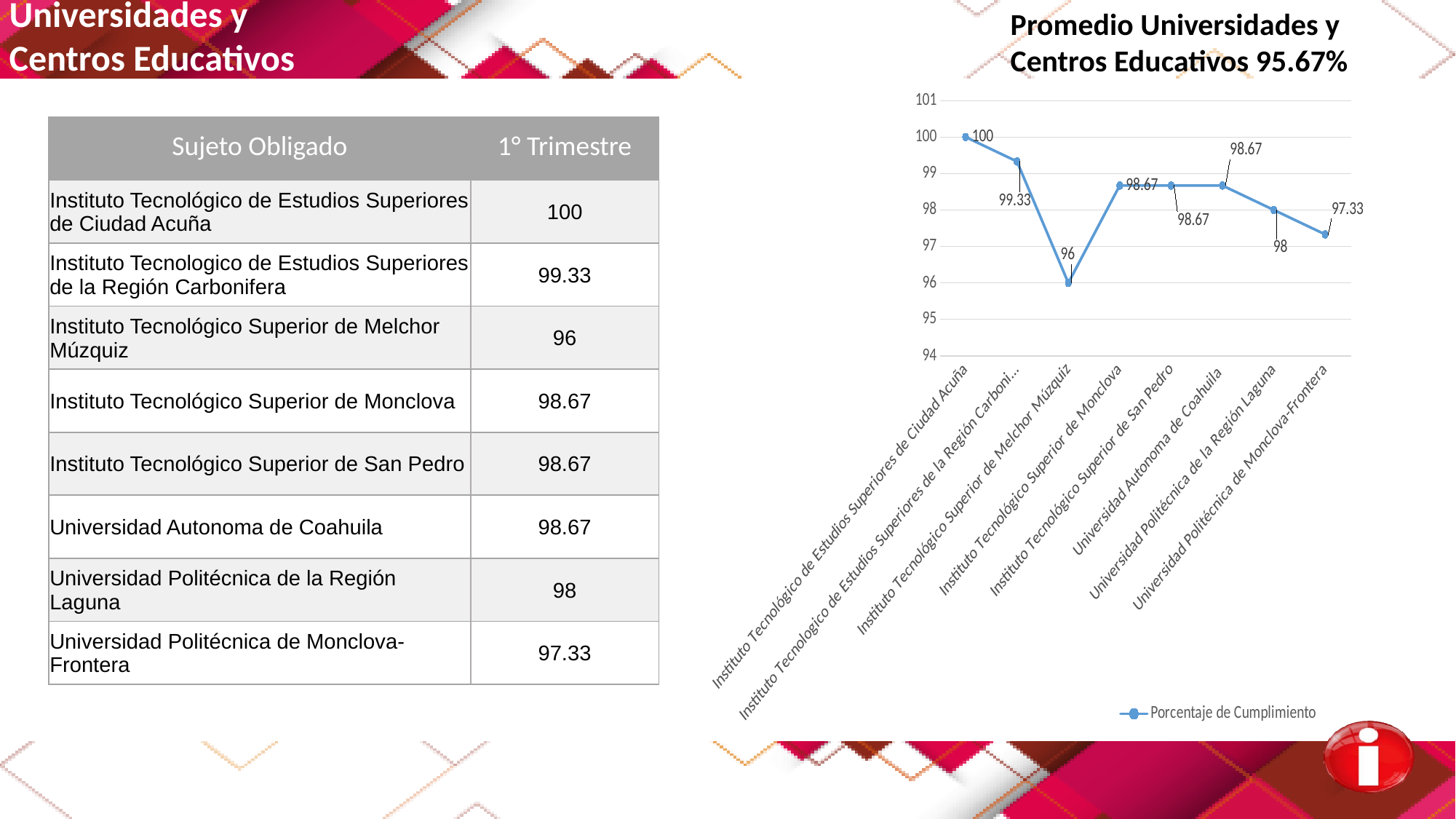
What is the value for Instituto Tecnológico Superior de Melchor Múzquiz in the chart? 96 Which category has the highest value in the chart? Instituto Tecnológico de Estudios Superiores de Ciudad Acuña What is the value for Universidad Politécnica de la Región Laguna in the chart? 98 Which is larger: the value for Universidad Autonoma de Coahuila or the value for Universidad Politécnica de la Región Laguna? Universidad Autonoma de Coahuila What is the difference between the value for Instituto Tecnológico de Estudios Superiores de Ciudad Acuña and the value for Instituto Tecnológico Superior de Melchor Múzquiz? 4 How many series does the chart legend list? 1 Is the value for Instituto Tecnológico Superior de Melchor Múzquiz greater or less than 97? less How many categories are plotted in the chart? 8 What type of chart is shown on the slide? Line chart What is the value for Universidad Politécnica de Monclova-Frontera in the chart? 97.33 Which category has the lowest value in the chart? Instituto Tecnológico Superior de Melchor Múzquiz What is the name of the series shown in the chart legend? Porcentaje de Cumplimiento